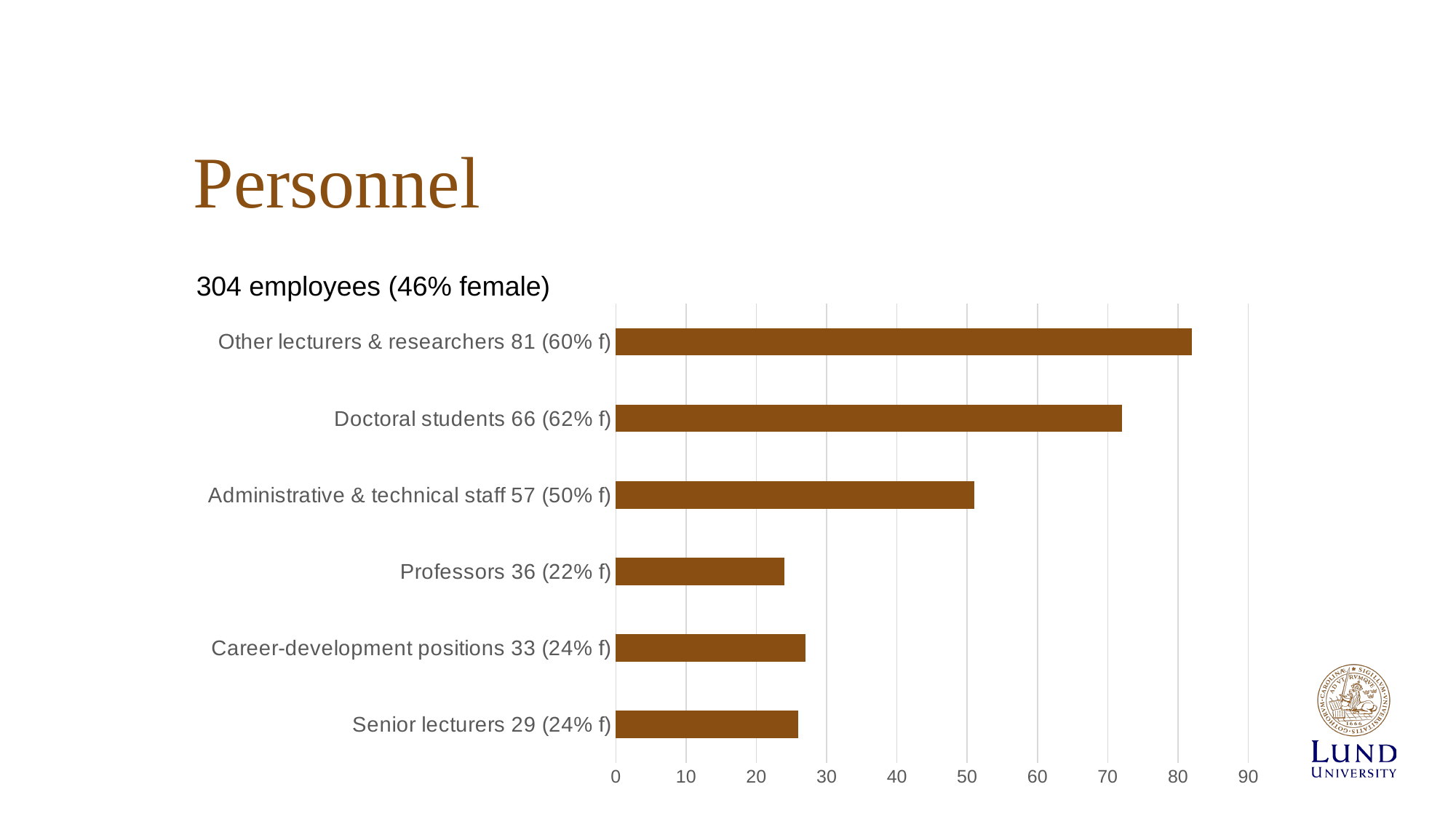
Is the bar for Administrative & technical staff greater or less than 60? less What kind of chart is shown on the slide? bar chart Which category has the longest bar in the chart? Other lecturers & researchers According to the text above the chart, how many employees are there in total? 304 What is the title of the slide containing the chart? Personnel Which bar is longer, Doctoral students or Administrative & technical staff? Doctoral students Which bar is longer, Professors or Administrative & technical staff? Administrative & technical staff Is the bar for Professors greater or less than 30? less How many categories does the bar chart show? 6 Is the bar for Other lecturers & researchers greater or less than 80? greater